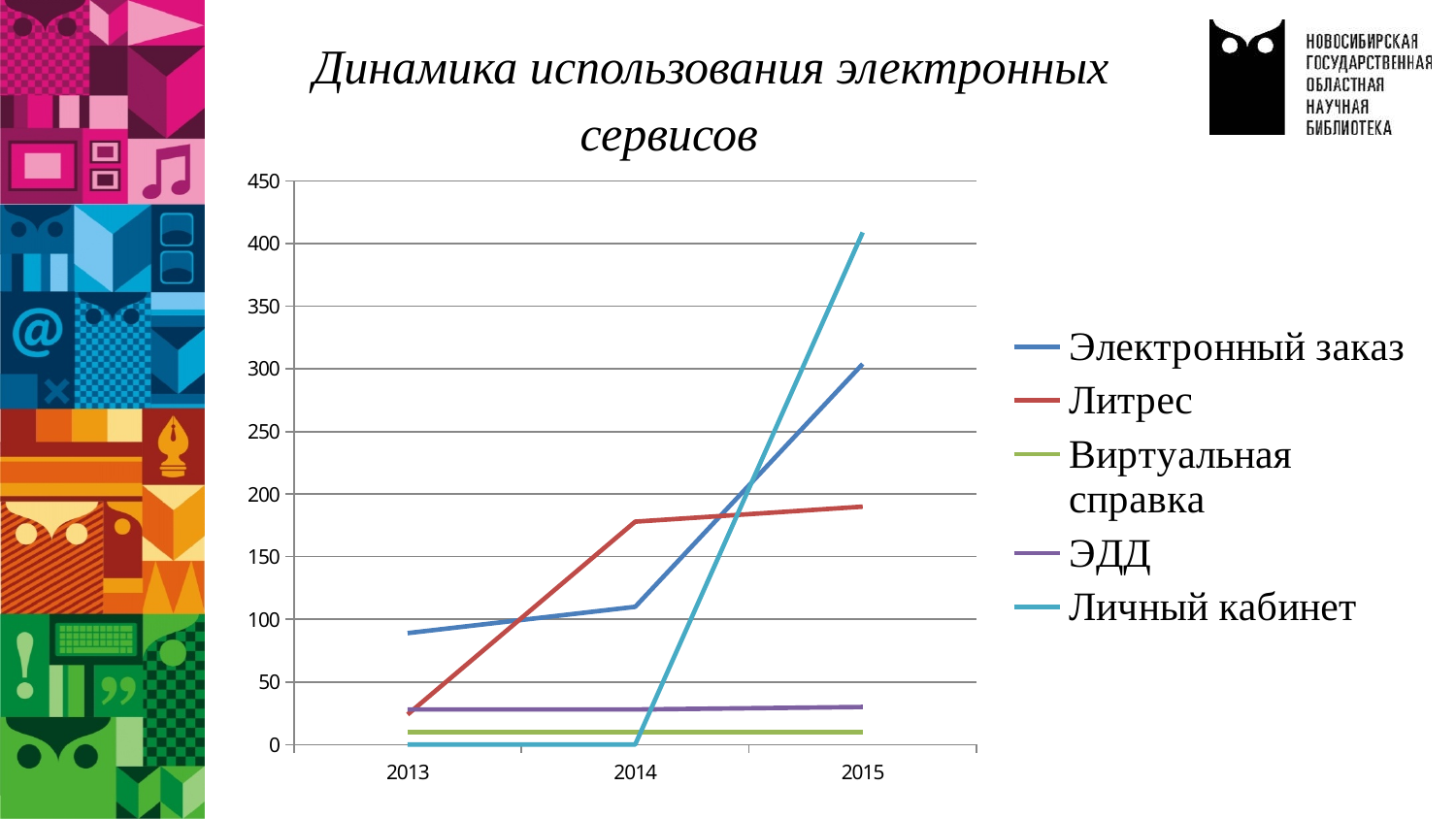
Which series has the lowest value in 2015? Виртуальная справка Which is larger in 2013: Электронный заказ or Литрес? Электронный заказ What kind of chart is shown on the slide? line chart Which series has the highest value in 2015? Личный кабинет Which series has the highest value in 2014? Литрес How many years are shown on the x axis? 3 How many series does the legend list? 5 Is the value for Литрес in 2014 greater or less than 150? greater What is the value for Личный кабинет in 2013? 0 Does the value for Электронный заказ rise or fall from 2013 to 2015? rise Is the value for Электронный заказ in 2015 greater or less than 350? less Is the value for Личный кабинет in 2015 greater or less than 400? greater